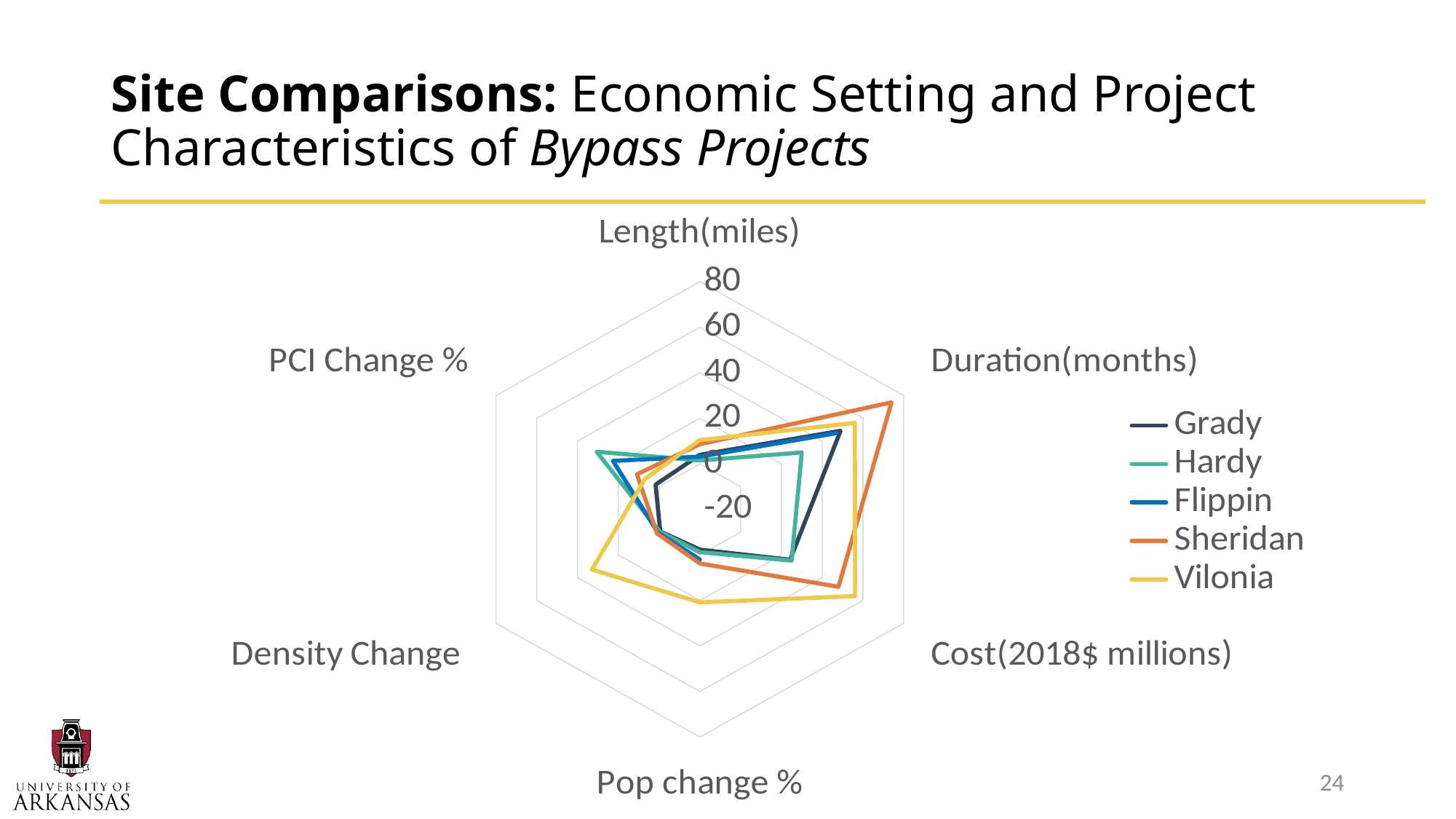
How many series does the legend list? 5 Which site has the highest PCI Change % value? Hardy Which sites are listed in the chart legend? Grady, Hardy, Flippin, Sheridan, Vilonia Which site has the highest Density Change value? Vilonia Which has the larger Duration(months) value, Sheridan or Hardy? Sheridan What kind of chart is shown on the slide? radar chart Which site has the highest Duration(months) value? Sheridan What is the highest value shown on the chart's axis scale? 80 Is the Duration(months) value for Sheridan greater or less than 60? greater Is the Cost(2018$ millions) value for Vilonia greater or less than 40? greater Is the Duration(months) value for Hardy greater or less than 40? less How many axes (categories) does the radar chart have? 6